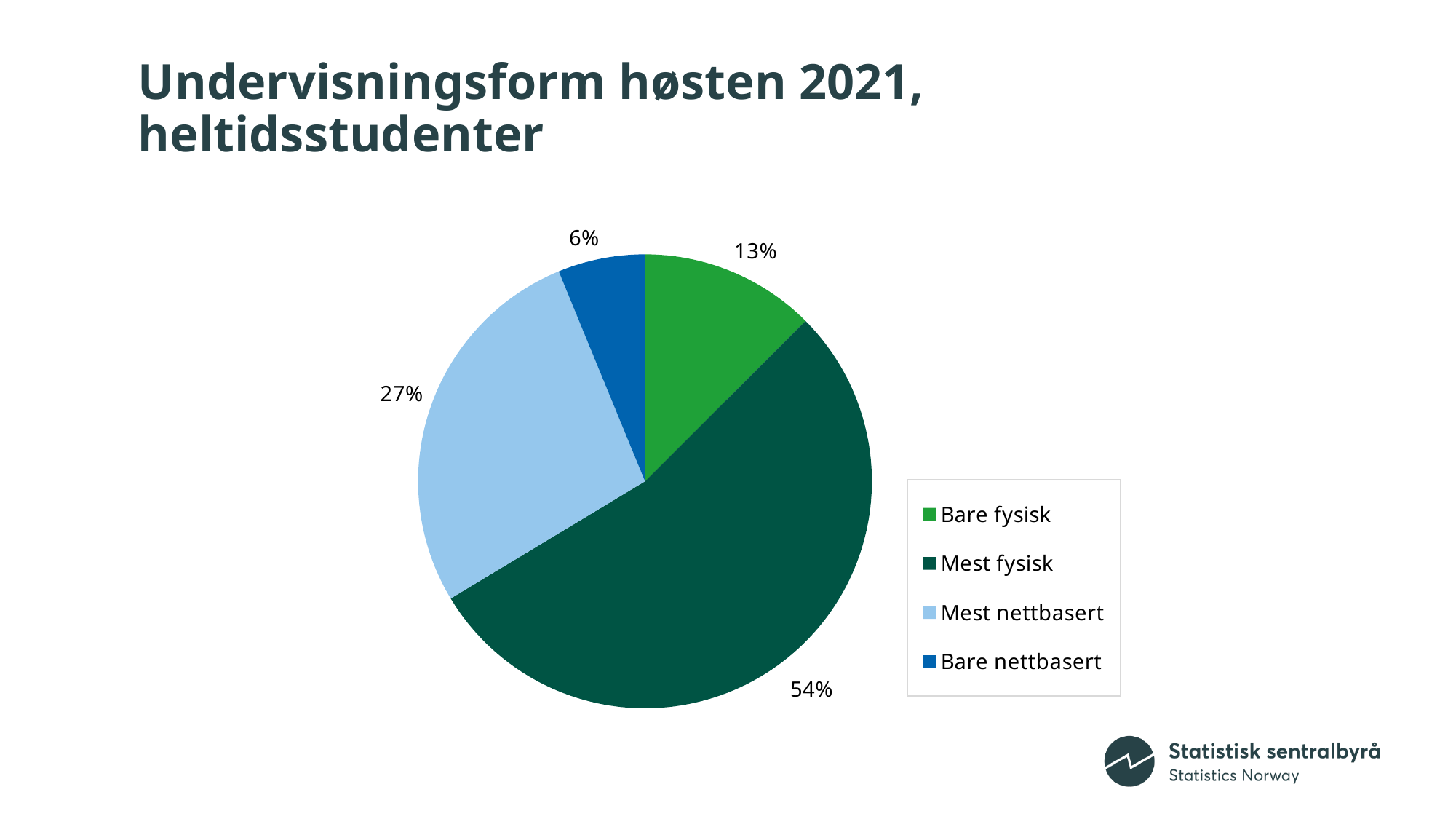
What kind of chart is shown on the slide? pie chart What colour is the 'Bare nettbasert' slice? dark blue What share of the pie is 'Mest fysisk'? 54% What is the difference in percentage points between 'Mest fysisk' and 'Mest nettbasert'? 27 What share of the pie is 'Bare fysisk'? 13% Which category has the largest slice of the pie? Mest fysisk Which is larger, 'Bare fysisk' or 'Mest nettbasert'? Mest nettbasert What is the title of the slide? Undervisningsform høsten 2021, heltidsstudenter What share of the pie is 'Bare nettbasert'? 6% How many categories does the pie chart have? 4 Which category has the smallest slice of the pie? Bare nettbasert